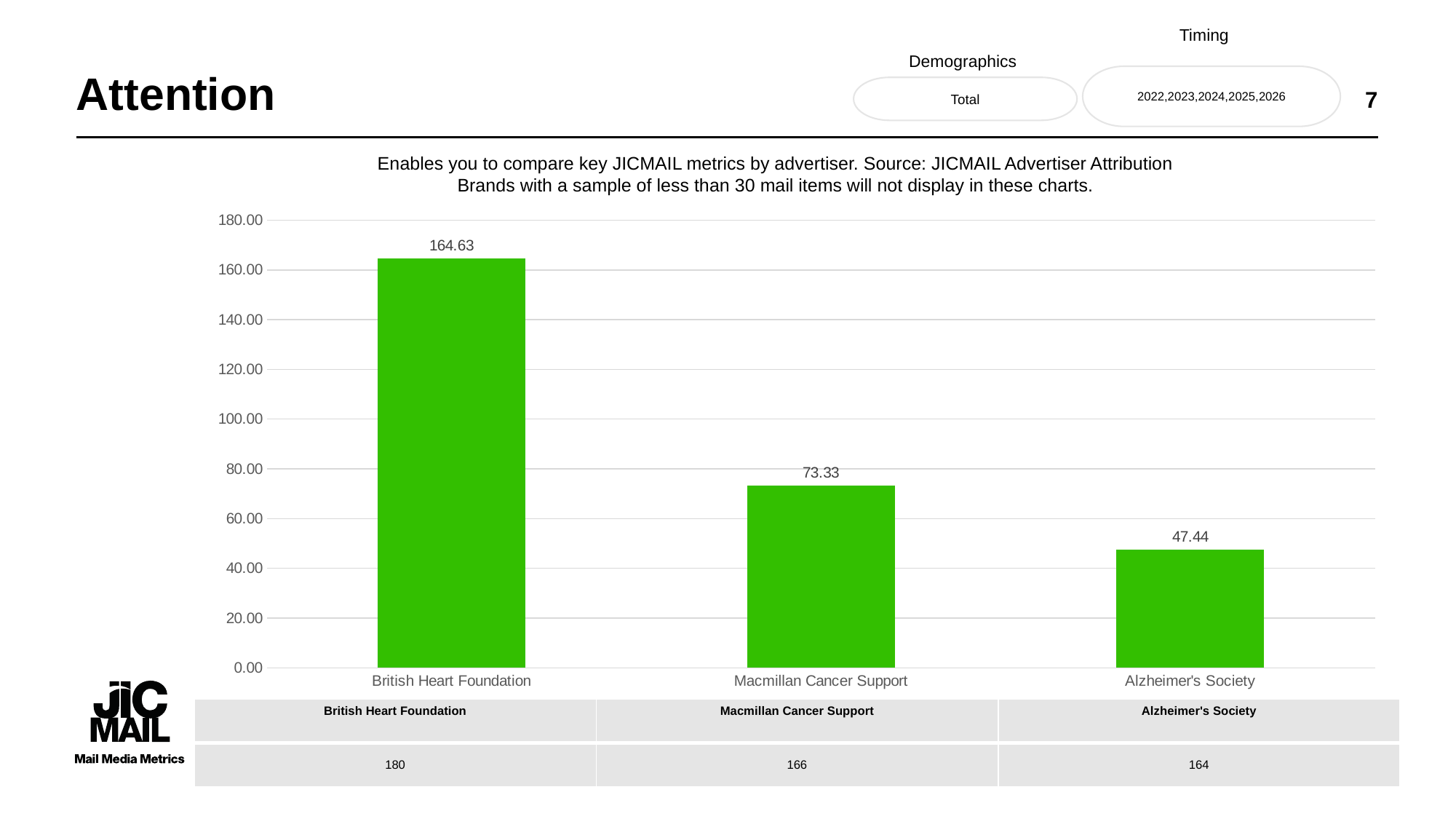
What is the value for Macmillan Cancer Support? 73.33 What is the value for British Heart Foundation? 164.63 What is the difference between the values for Macmillan Cancer Support and Alzheimer's Society? 25.89 How many advertisers are shown in the chart? 3 Which advertiser has the highest value? British Heart Foundation What is the value for Alzheimer's Society? 47.44 Which is larger, the value for Macmillan Cancer Support or the value for Alzheimer's Society? Macmillan Cancer Support What kind of chart is shown on the slide? bar chart What is the difference between the values for British Heart Foundation and Macmillan Cancer Support? 91.30 Which advertiser has the lowest value? Alzheimer's Society Do the values rise or fall from left to right across the advertisers? fall Is the value for British Heart Foundation greater or less than 160.00? greater